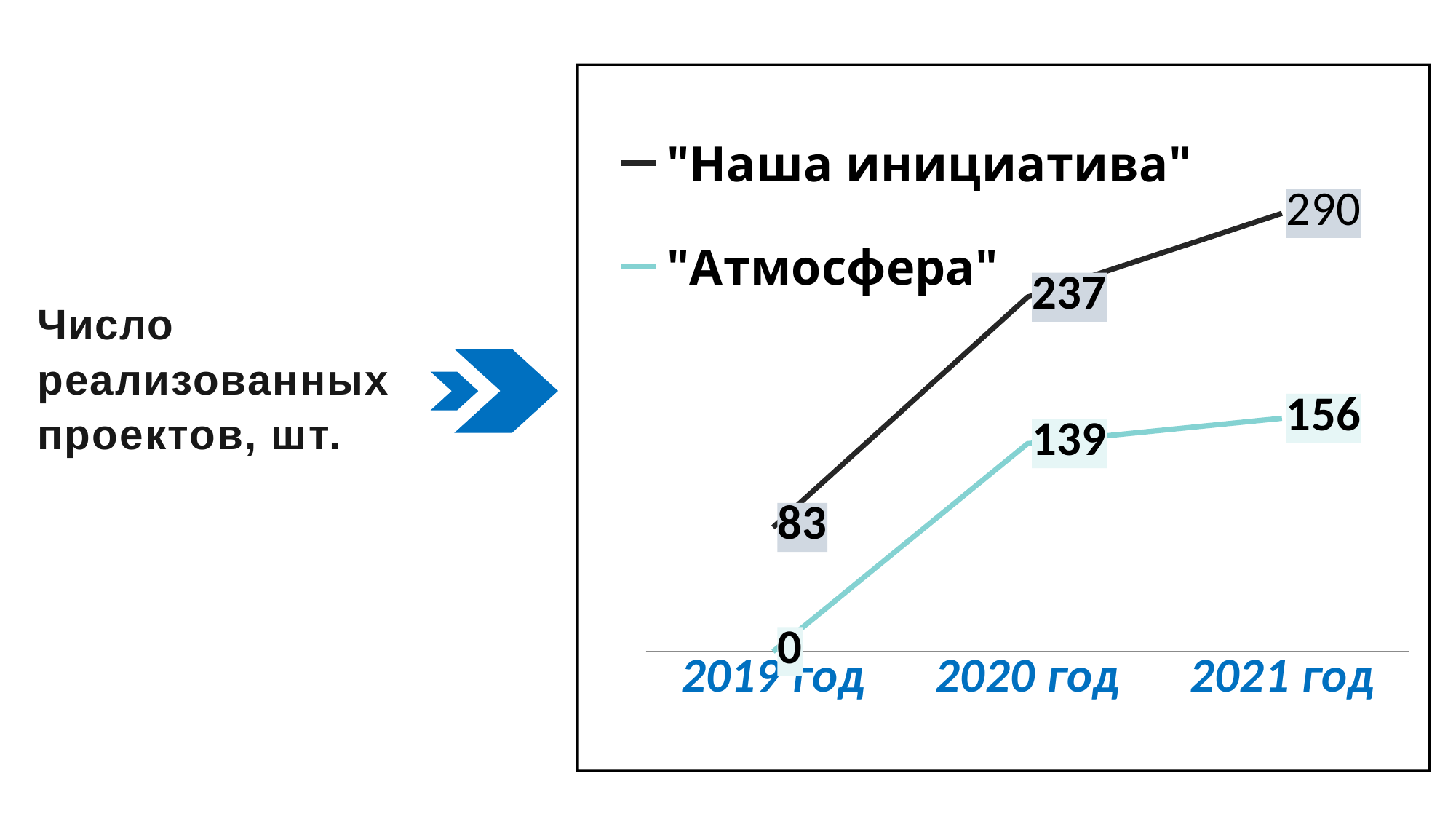
Which series has the larger value in 2020 год, "Наша инициатива" or "Атмосфера"? "Наша инициатива" How many series does the legend list? 2 What is the value for "Наша инициатива" in 2019 год? 83 What kind of chart is shown? line chart What is the value for "Наша инициатива" in 2020 год? 237 In which year is the value for "Атмосфера" lowest? 2019 год What is the difference between "Наша инициатива" and "Атмосфера" in 2021 год? 134 In which year is the value for "Наша инициатива" highest? 2021 год How many years are shown on the x axis? 3 Does the value for "Атмосфера" rise or fall from 2019 год to 2021 год? rise What is the value for "Атмосфера" in 2019 год? 0 What is the value for "Атмосфера" in 2021 год? 156